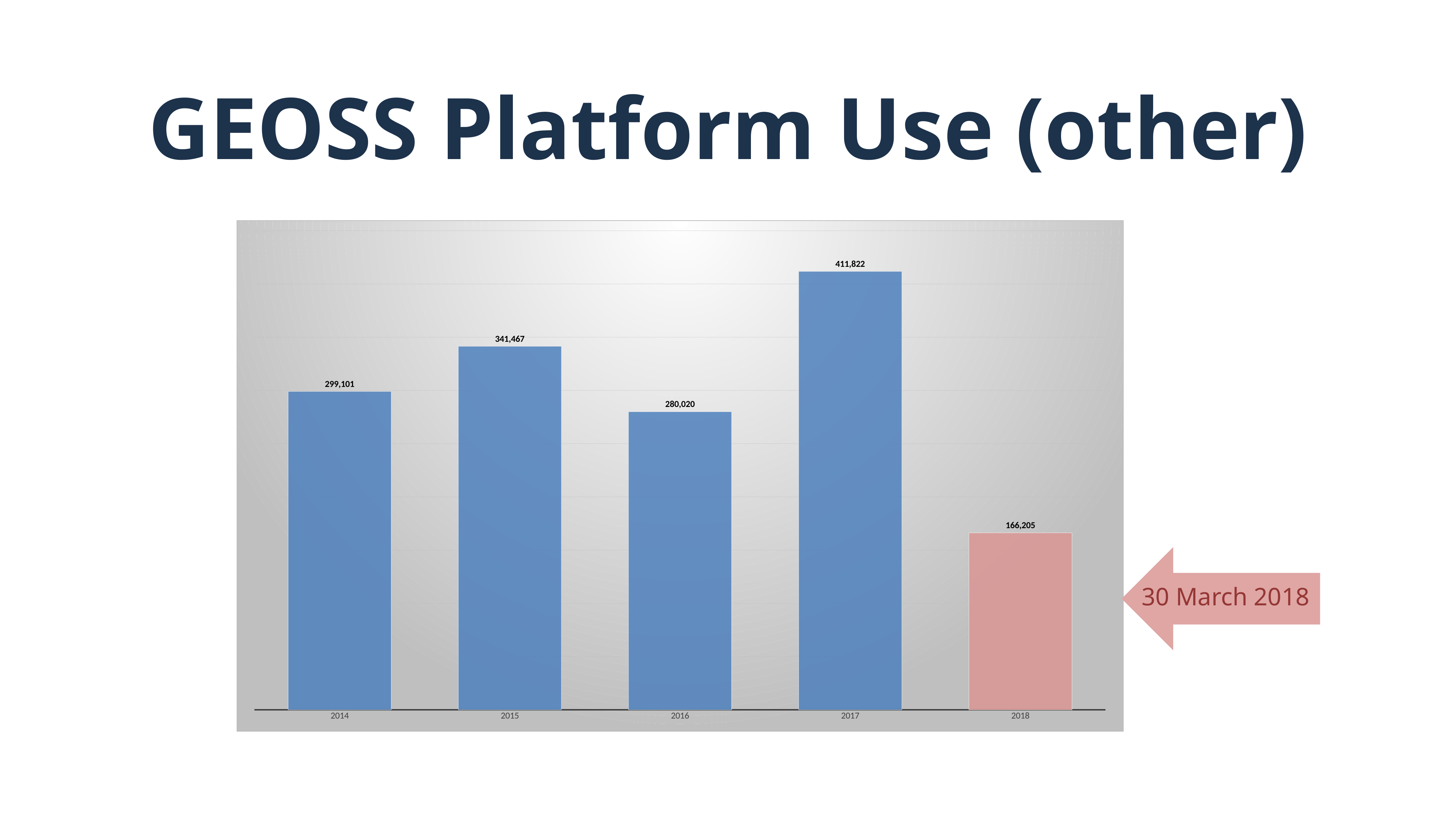
What is the value for 2017? 411,822 What is the value for 2016? 280,020 What kind of chart is shown on the slide? Bar chart What is the value for 2014? 299,101 What is the difference between the values for 2015 and 2014? 42,366 What is the value for 2018? 166,205 How many years are shown on the chart? 5 What is the difference between the values for 2017 and 2016? 131,802 Which is larger, the value for 2015 or the value for 2016? 2015 Which year has the lowest value? 2018 Which year has the highest value? 2017 What date does the arrow next to the 2018 bar indicate? 30 March 2018